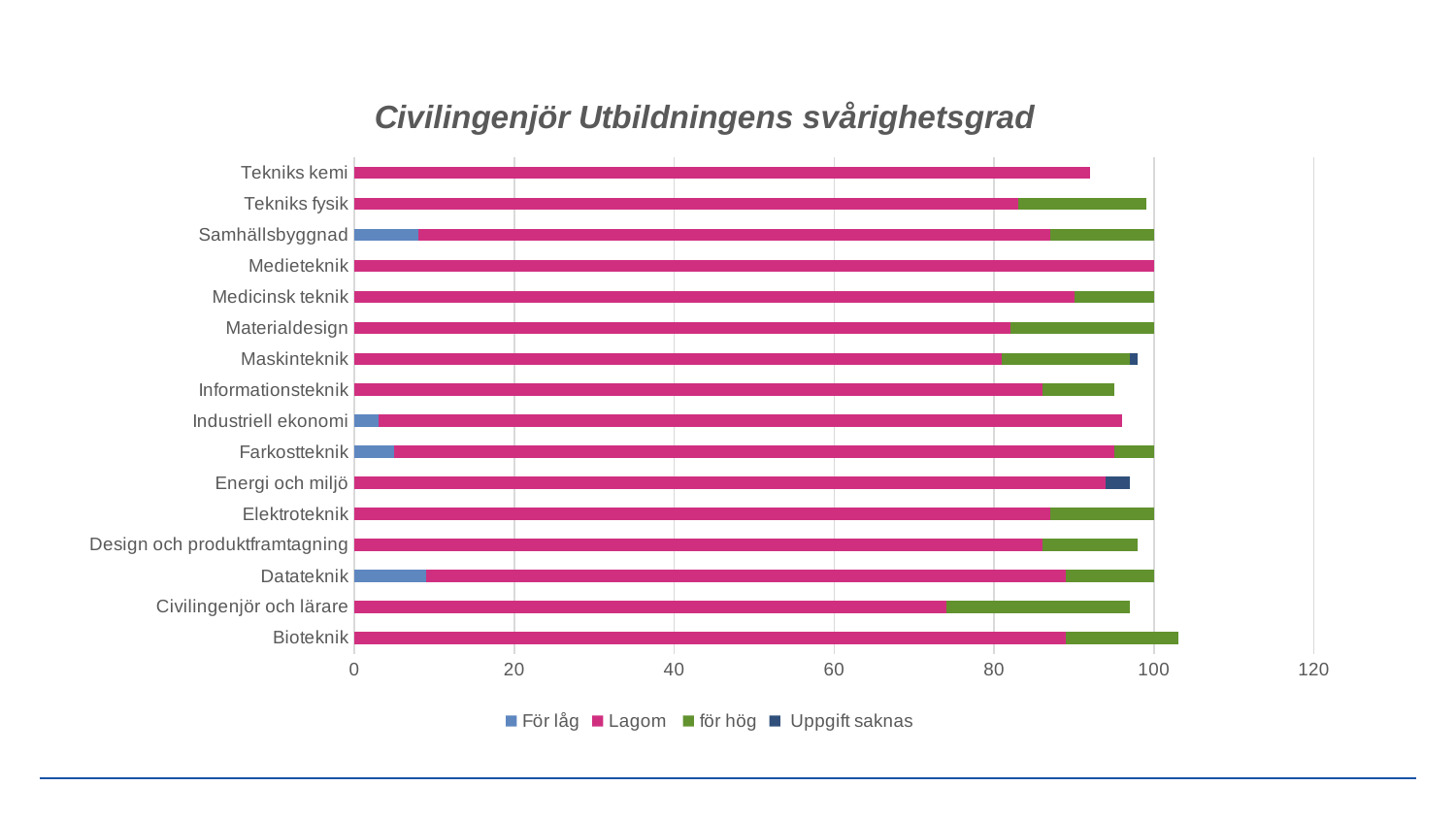
How many programmes (categories) are shown on the vertical axis? 16 Which programme has the lowest Lagom value? Civilingenjör och lärare Which programme has the highest Lagom value? Medieteknik What kind of chart is shown on the slide? Stacked bar chart Is the Lagom value for Civilingenjör och lärare greater or less than 80? less Which series is shown in green in the legend? för hög Is the För låg value for Datateknik greater or less than 20? less Is the Lagom value for Tekniks kemi greater or less than 80? greater Which has the larger För låg value, Datateknik or Industriell ekonomi? Datateknik How many series does the legend list? 4 What is the title of the chart? Civilingenjör Utbildningens svårighetsgrad How many programmes show a visible Uppgift saknas segment? 2